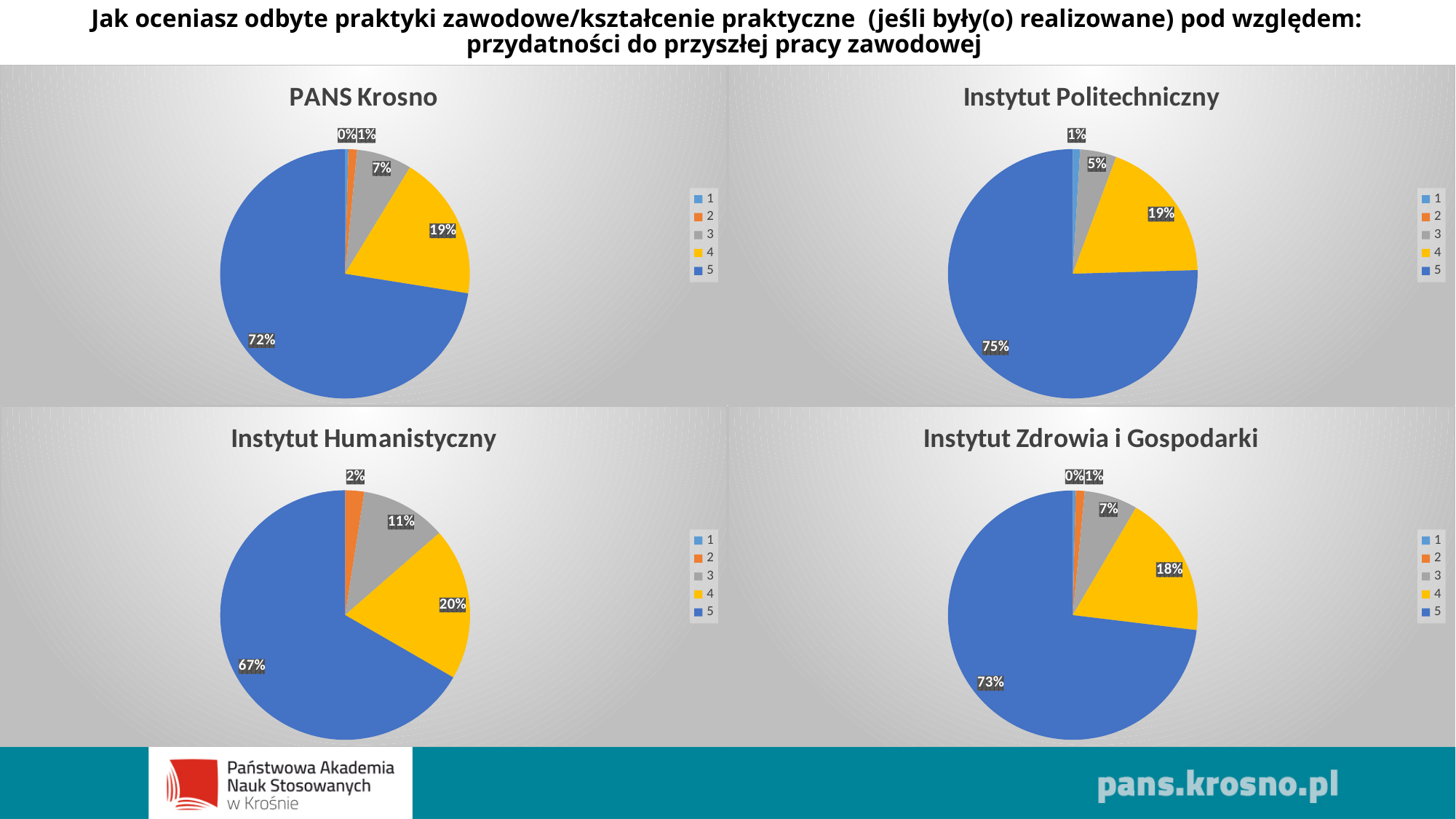
In the Instytut Politechniczny chart, what is the difference between the percentages for category 5 and category 4? 56% In the PANS Krosno chart, what percentage is shown for category 5? 72% How many charts are shown on the slide? 4 How many entries does the legend of the Instytut Zdrowia i Gospodarki chart list? 5 In the Instytut Humanistyczny chart, which category has the largest slice? 5 In the Instytut Zdrowia i Gospodarki chart, what percentage is shown for category 5? 73% In the Instytut Politechniczny chart, what percentage is shown for category 4? 19% In the Instytut Humanistyczny chart, what is the difference between the percentages for category 4 and category 3? 9% In the Instytut Humanistyczny chart, what percentage is shown for category 3? 11% Which is larger: the category 5 share in the Instytut Politechniczny chart or the category 5 share in the Instytut Humanistyczny chart? Instytut Politechniczny In the PANS Krosno chart, which category has the smallest slice? 1 What type of chart is used for PANS Krosno? Pie chart